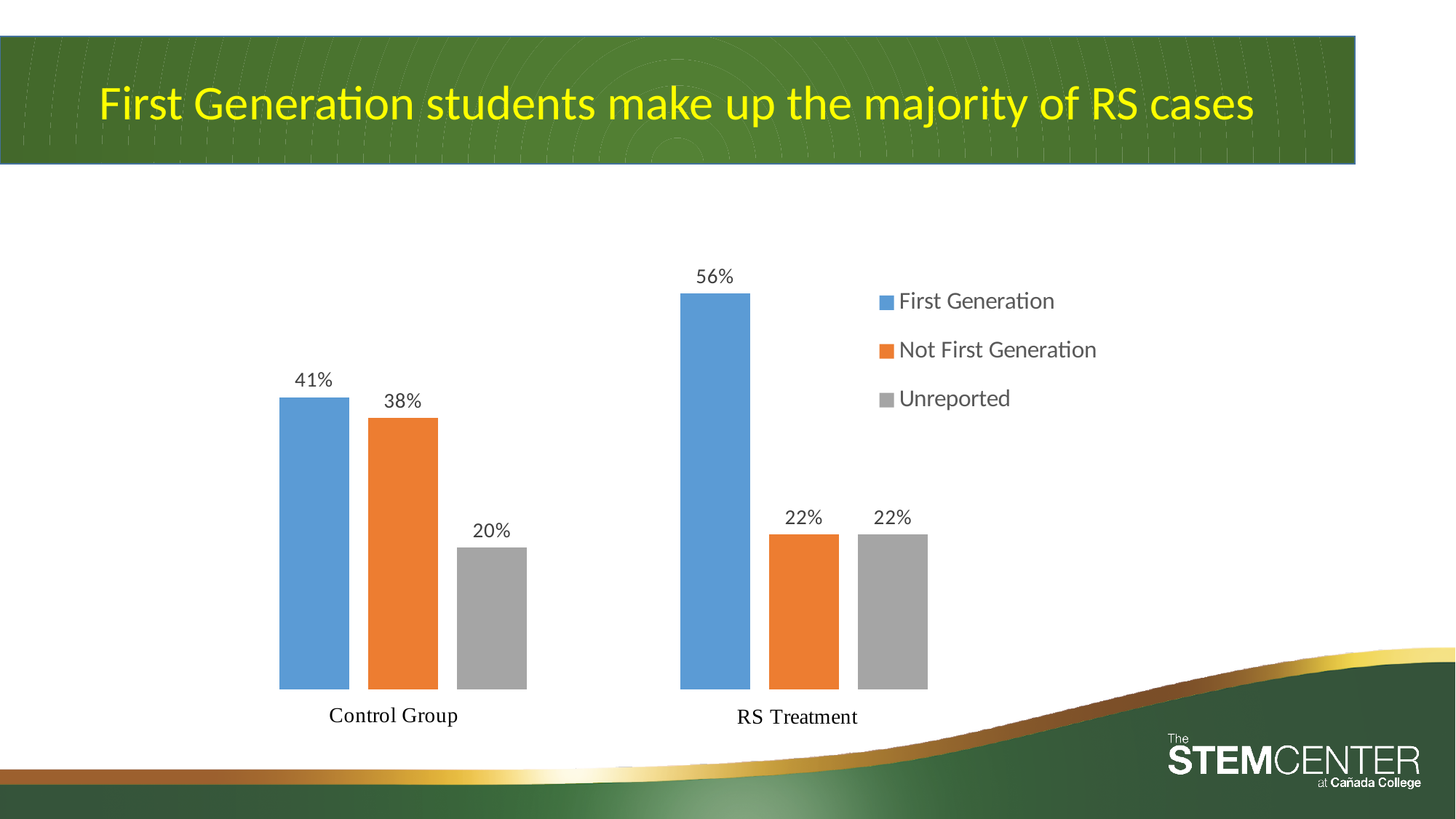
What is the value for Unreported in the Control Group? 20% What kind of chart is shown on the slide? Bar chart How many categories are shown on the x axis? 2 How many series does the legend list? 3 What is the difference between the First Generation values for RS Treatment and Control Group? 15% Which series has the highest value in the RS Treatment group? First Generation What is the value for Not First Generation in the RS Treatment group? 22% Which series has the lowest value in the Control Group? Unreported What is the value for First Generation in the RS Treatment group? 56% What is the value for First Generation in the Control Group? 41% Which is larger: Not First Generation in the Control Group or Not First Generation in RS Treatment? Control Group What is the difference between First Generation and Not First Generation in the Control Group? 3%